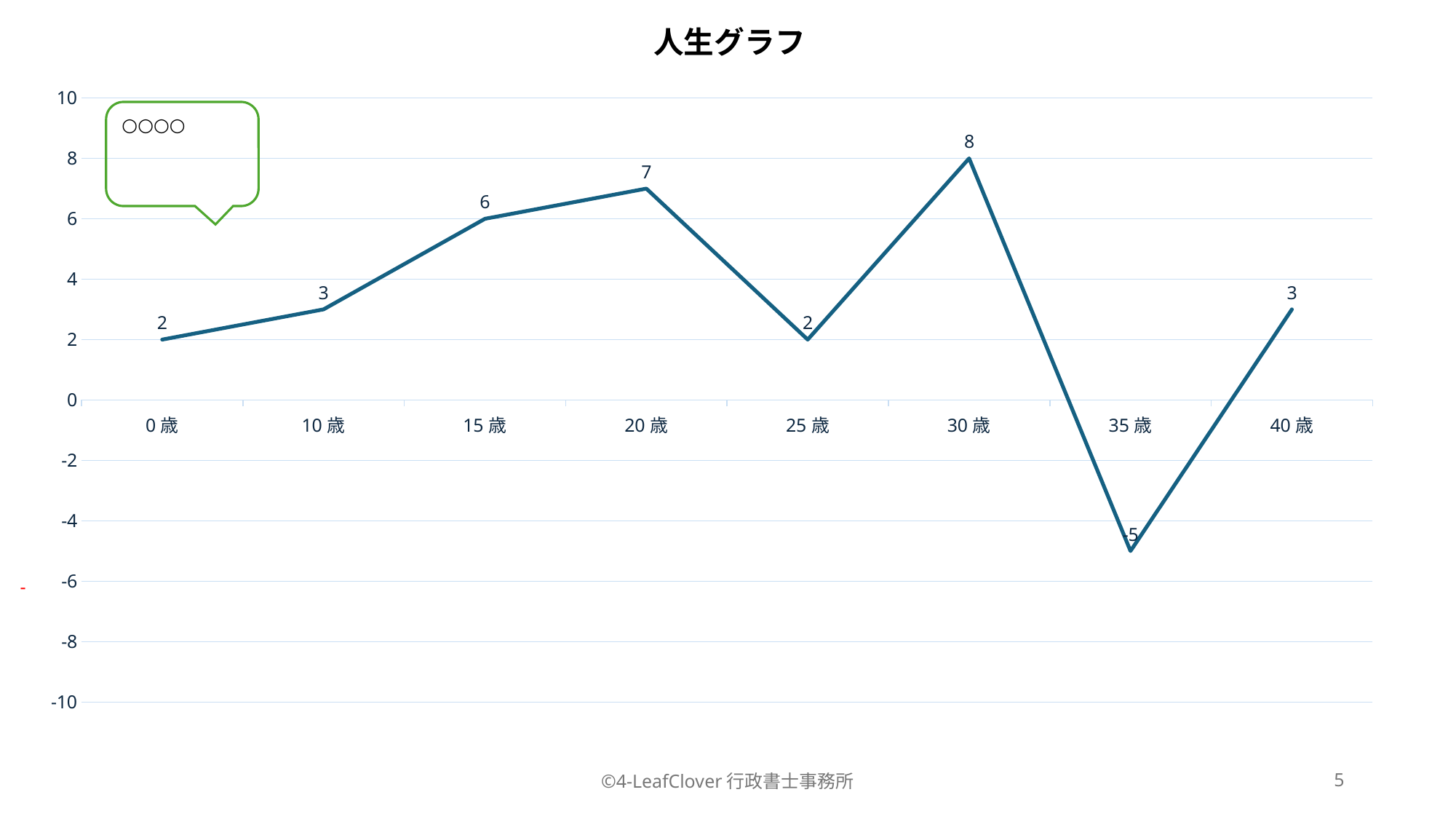
What is the value at 20歳? 7 What is the difference between the values at 30歳 and 25歳? 6 Which is larger, the value at 15歳 or the value at 40歳? 15歳 Does the value rise or fall from 30歳 to 35歳? fall What is the title of the chart? 人生グラフ What is the value at 0歳? 2 What is the value at 35歳? -5 How many age points are plotted on the chart? 8 At which age is the value highest? 30歳 What kind of chart is shown on the slide? line chart At which age is the value lowest? 35歳 Is the value at 30歳 greater or less than 6? greater